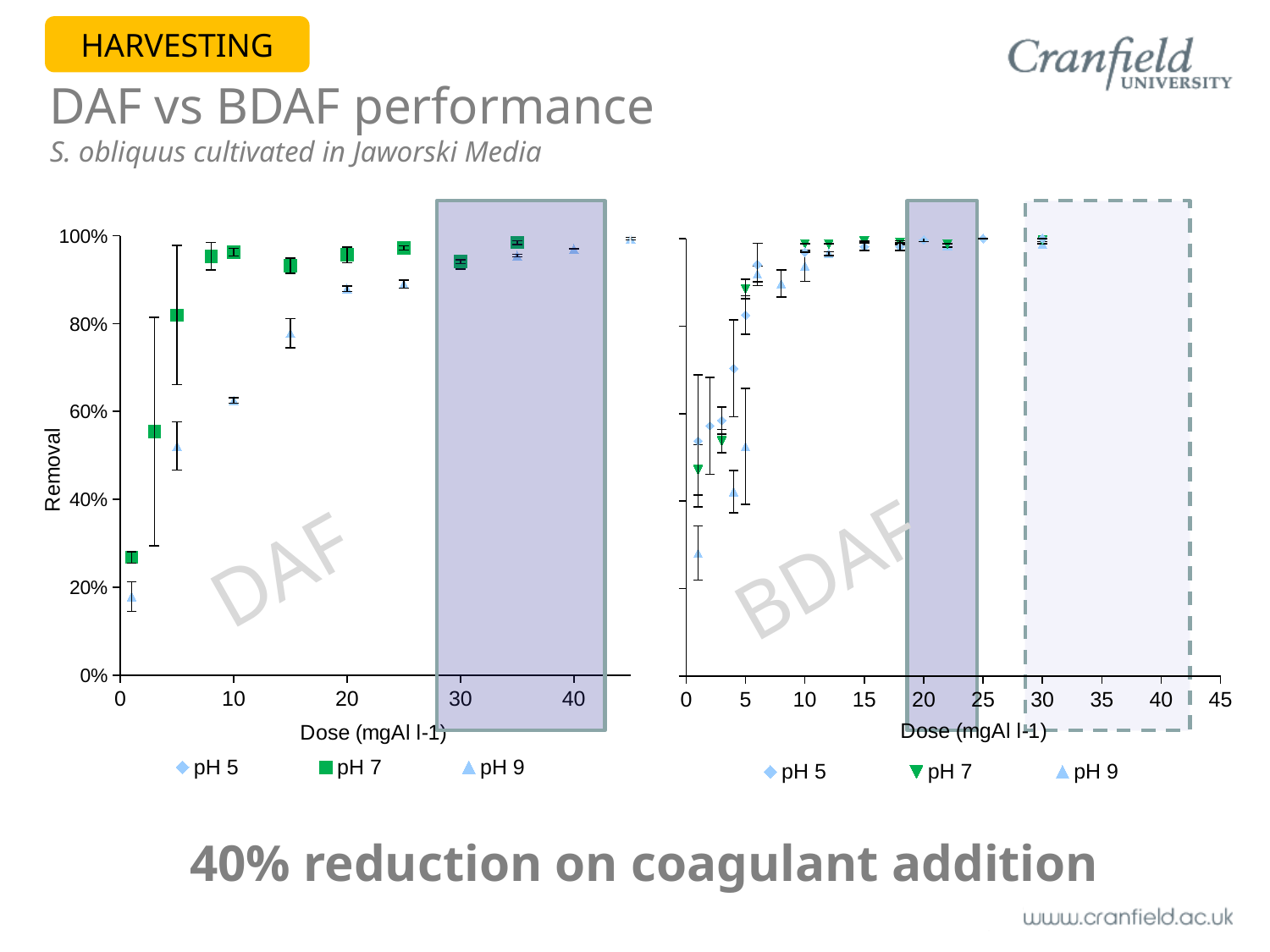
What kind of chart is the left (DAF) chart? scatter chart In the right (BDAF) chart, is the pH 9 removal at a dose of 1 greater or less than 40%? less In the left (DAF) chart, is the pH 7 removal at a dose of 1 greater or less than 40%? less In the left (DAF) chart, is the pH 7 removal at a dose of 10 greater or less than 80%? greater In the right (BDAF) chart, at a dose of 1, which series has the higher removal, pH 7 or pH 9? pH 7 What is the y-axis title of the left (DAF) chart? Removal In the left (DAF) chart, at a dose of 10, which series has the higher removal, pH 7 or pH 9? pH 7 How many series does the legend of the right (BDAF) chart list? 3 In the right (BDAF) chart, do the removal values generally rise or fall as the dose increases? rise What is the x-axis title of the right (BDAF) chart? Dose (mgAl l-1)